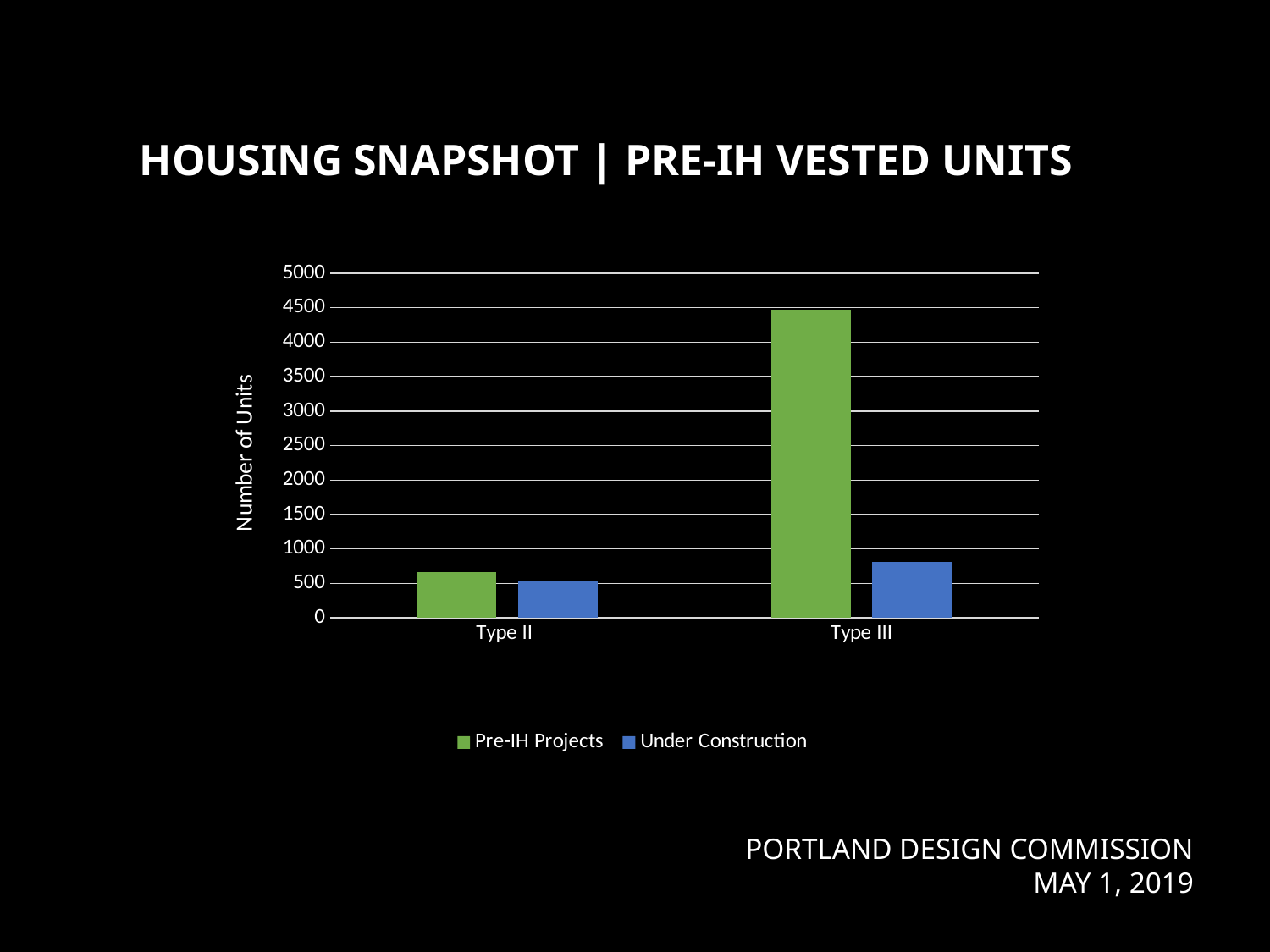
What kind of chart is shown on the slide? bar chart Which category has the highest Pre-IH Projects value? Type III Is the Under Construction value for Type III greater or less than 500? greater Is the Pre-IH Projects value for Type II greater or less than 1000? less For Type III, which is larger: Pre-IH Projects or Under Construction? Pre-IH Projects How many categories are shown on the x axis? 2 How many series does the legend list? 2 Which colour represents the Under Construction series? blue What is the label of the vertical axis? Number of Units Which category has the lowest Under Construction value? Type II Is the Under Construction value for Type III greater or less than 1000? less